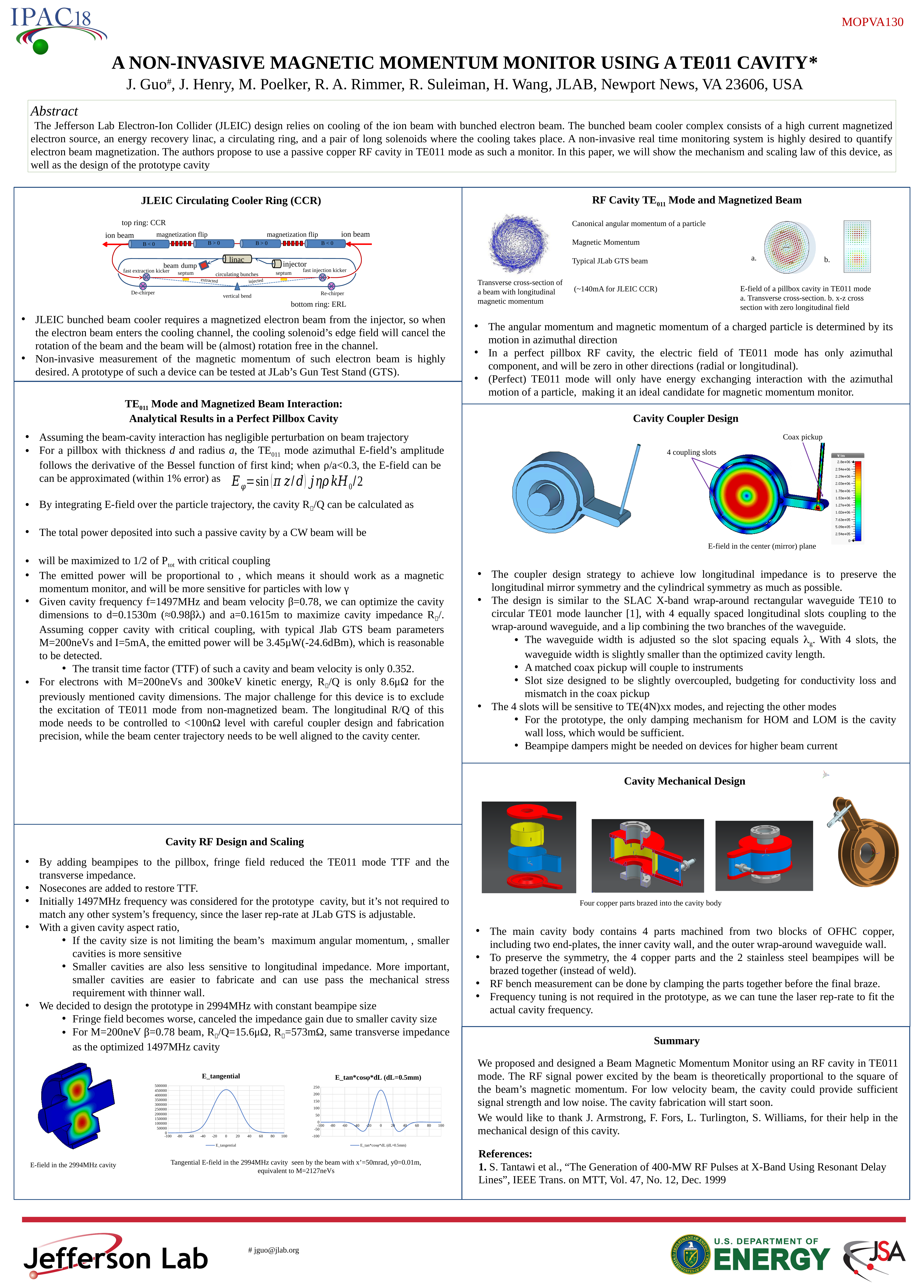
In the "E_tan*cosφ*dL (dL=0.5mm)" chart, is the peak value greater or less than 150? greater In the "E_tangential" chart, is the peak value greater or less than 400000? greater In the "E_tangential" chart, does the curve rise or fall as x goes from 0 to 100? fall In the "E_tangential" chart, at which x-axis value does the curve reach its maximum? 0 What kind of chart is the "E_tan*cosφ*dL (dL=0.5mm)" chart at the bottom of the poster? line chart What is the legend entry shown below the right-hand line chart at the bottom of the poster? E_tan*cosφ*dL (dL=0.5mm) In the "E_tangential" chart, is the peak value greater or less than 500000? less How many series does the legend of the "E_tan*cosφ*dL (dL=0.5mm)" chart list? 1 What kind of chart is the "E_tangential" chart at the bottom left of the poster? line chart How many series does the legend of the "E_tangential" chart list? 1 What is the title of the left-hand line chart at the bottom of the poster? E_tangential